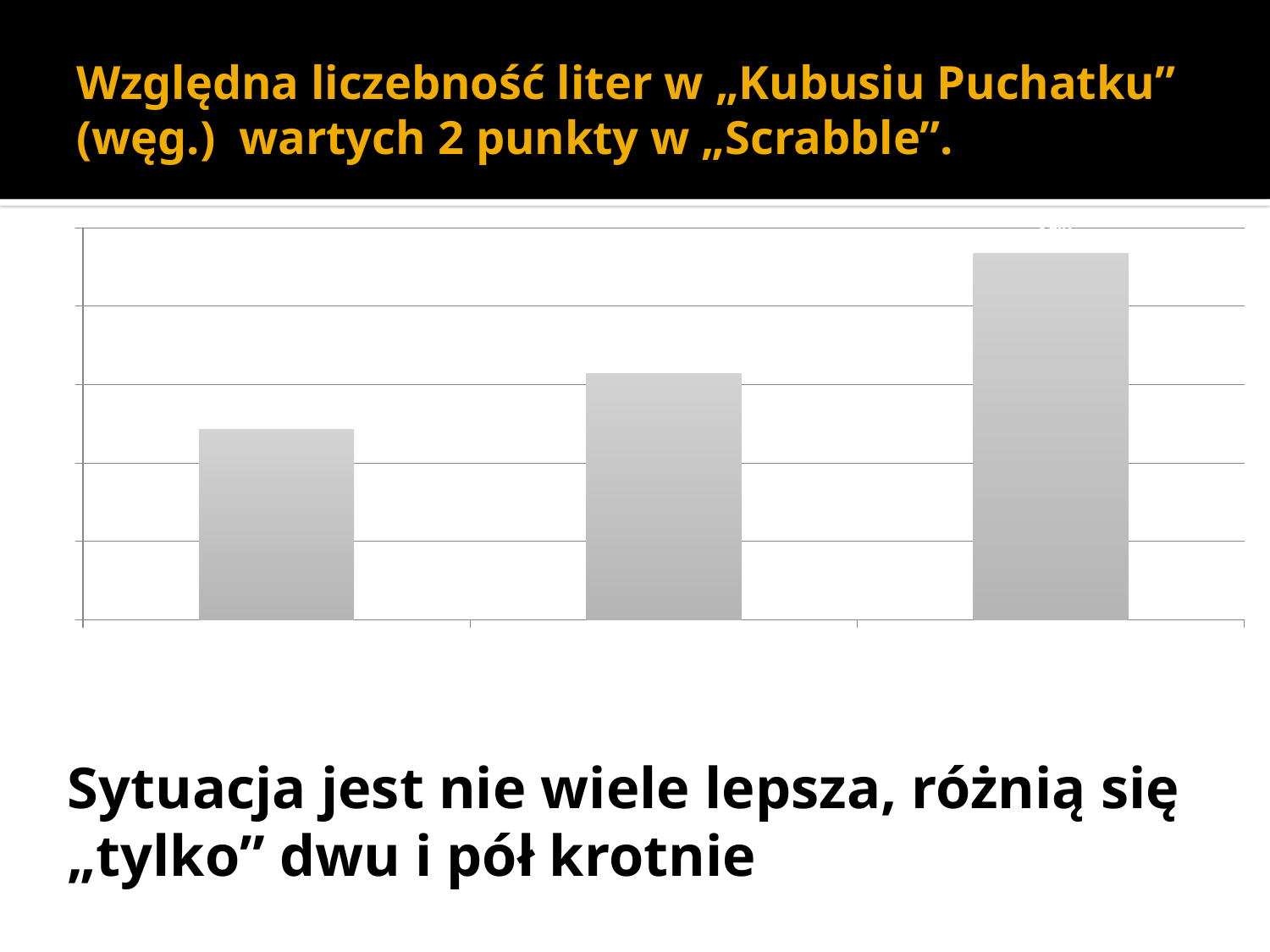
What colour are the bars in the chart? grey According to the slide title, how many Scrabble points are the letters in the chart worth? 2 Do the bar heights rise or fall from left to right? rise Which is taller, the left bar or the middle bar? middle bar Which is taller, the middle bar or the right bar? right bar Which bar is the tallest: the left, middle or right one? right Which bar is the shortest: the left, middle or right one? left What kind of chart is shown on the slide? bar chart How many bars does the chart show? 3